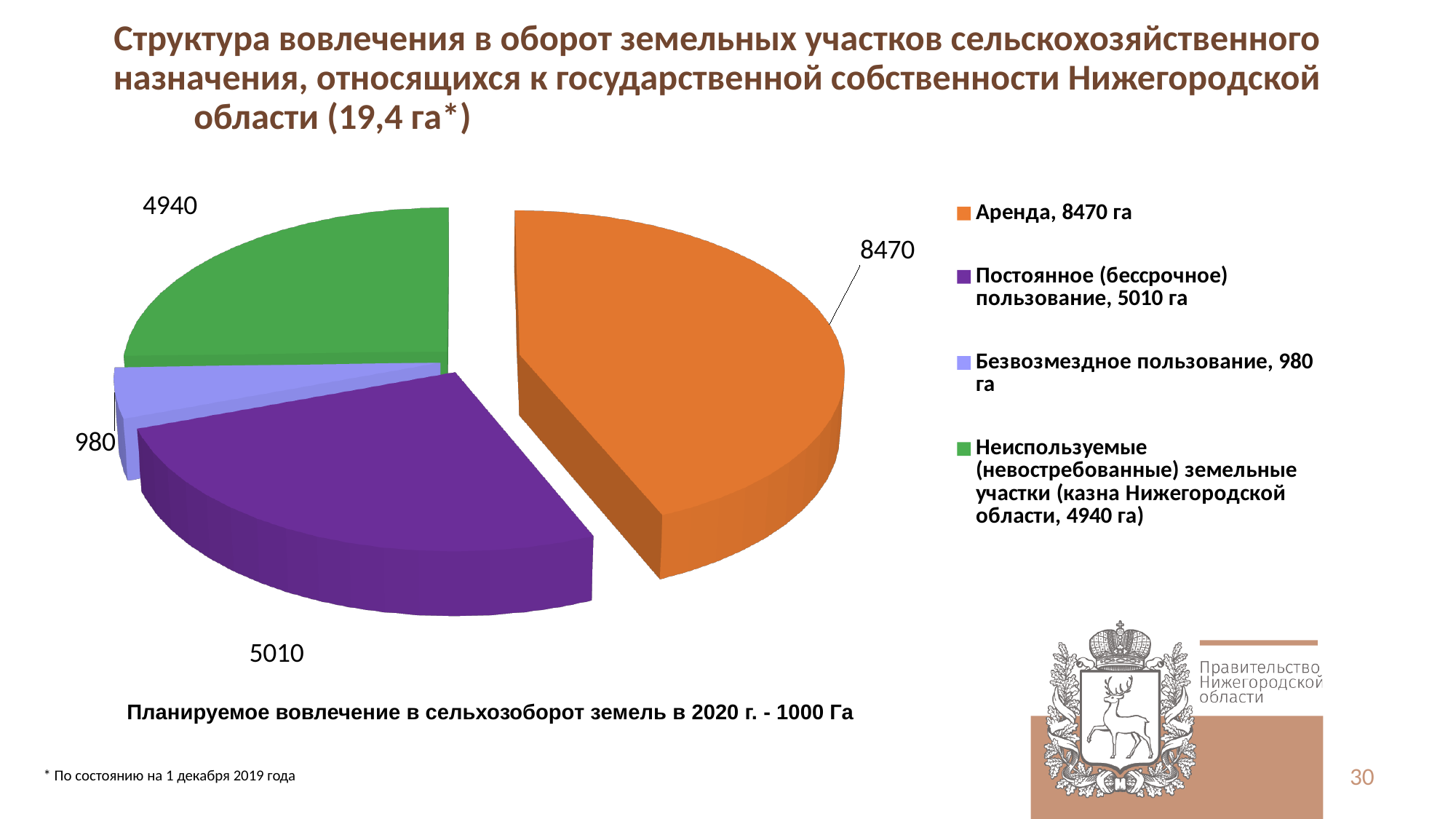
Which category has the smallest slice of the pie? Безвозмездное пользование What is the value for Постоянное (бессрочное) пользование? 5010 What is the value for Безвозмездное пользование? 980 Which is larger: the value for Аренда or the value for Неиспользуемые (невостребованные) земельные участки? Аренда Which category has the largest slice of the pie? Аренда What type of chart is shown on the slide? Pie chart What is the difference between the values for Неиспользуемые (невостребованные) земельные участки and Безвозмездное пользование? 3960 How many categories does the legend list? 4 What is the value for Аренда? 8470 What is the difference between the values for Аренда and Постоянное (бессрочное) пользование? 3460 What is the value for Неиспользуемые (невостребованные) земельные участки (казна Нижегородской области)? 4940 What colour is the slice for Аренда? Orange